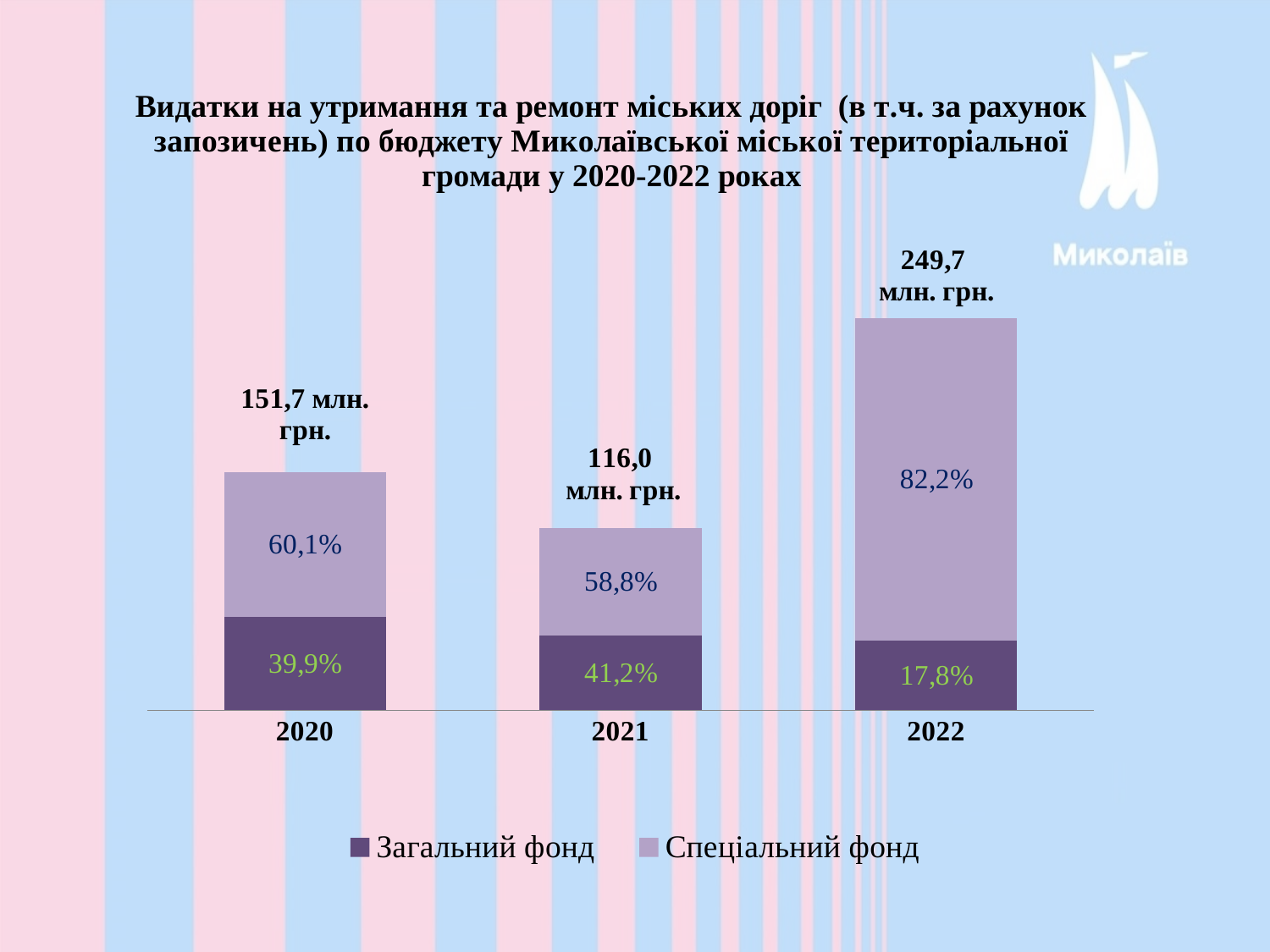
What share of the 2022 bar is Спеціальний фонд? 82,2% Which year has the lowest total expenditure? 2021 What is the total expenditure shown above the bar for 2022? 249,7 млн. грн. How many years (categories) are shown on the x axis? 3 Which year has the highest total expenditure? 2022 What is the difference between the total expenditure in 2022 and in 2020, in млн. грн.? 98,0 млн. грн. Which series is shown in the darker purple colour at the bottom of each bar? Загальний фонд What is the total expenditure shown above the bar for 2020? 151,7 млн. грн. What share of the 2020 bar is Спеціальний фонд? 60,1% What type of chart is shown on the slide? Stacked bar chart What share of the 2021 bar is Загальний фонд? 41,2% How many series does the legend list? 2